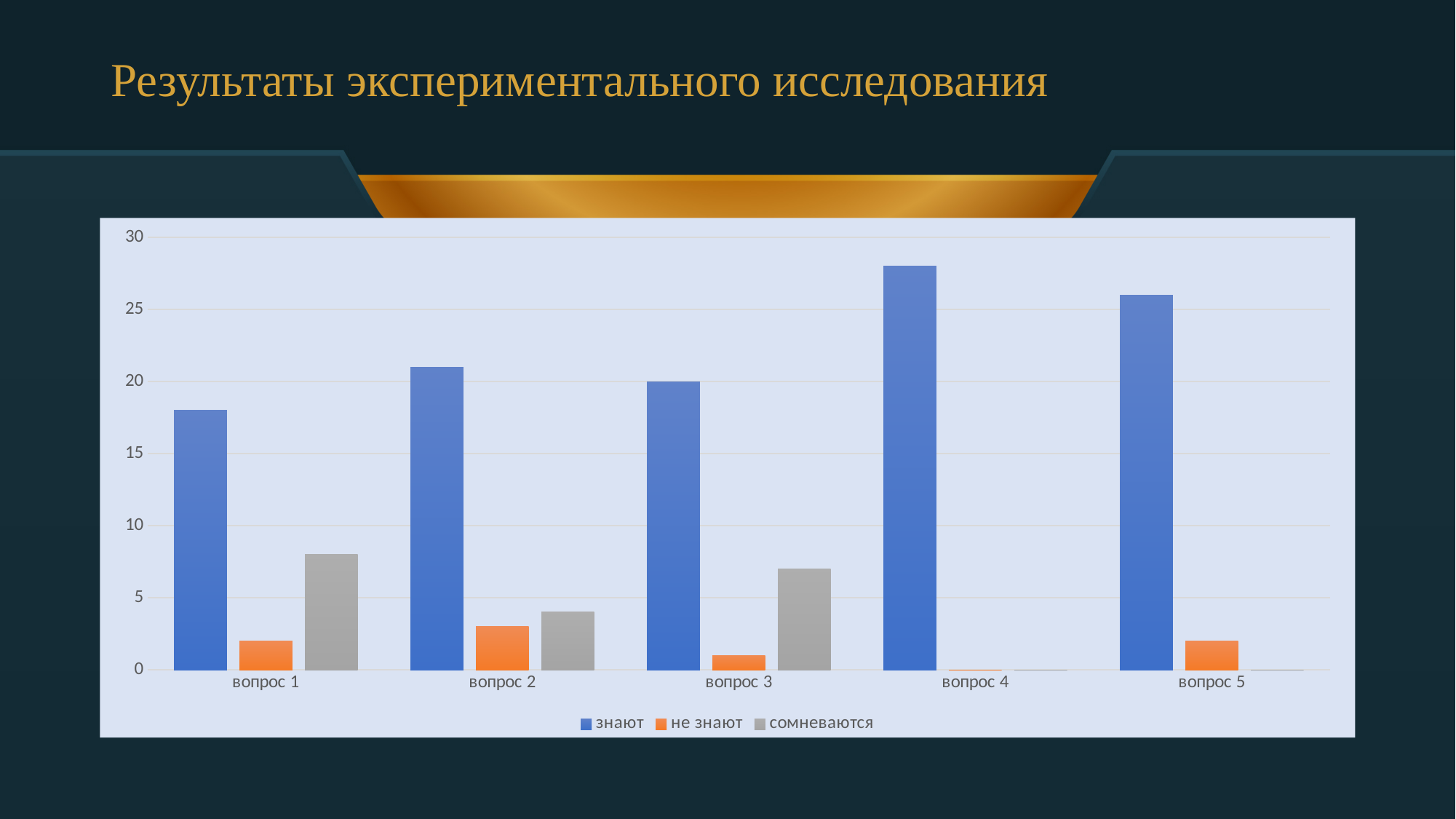
Which category has the highest value for the series 'знают'? вопрос 4 Which is larger: the 'сомневаются' value for вопрос 2 or for вопрос 3? вопрос 3 Is the value for 'знают' in вопрос 4 greater or less than 25? greater What kind of chart is shown on the slide? bar chart How many series does the legend list? 3 Which category has the lowest value for the series 'знают'? вопрос 1 Is the value for 'сомневаются' in вопрос 1 greater or less than 5? greater How many categories (вопрос) are shown on the x axis? 5 Is the value for 'знают' in вопрос 1 greater or less than 20? less What is the title of the slide containing the chart? Результаты экспериментального исследования Which category has the highest value for the series 'сомневаются'? вопрос 1 Which is larger: the 'знают' value for вопрос 2 or for вопрос 5? вопрос 5